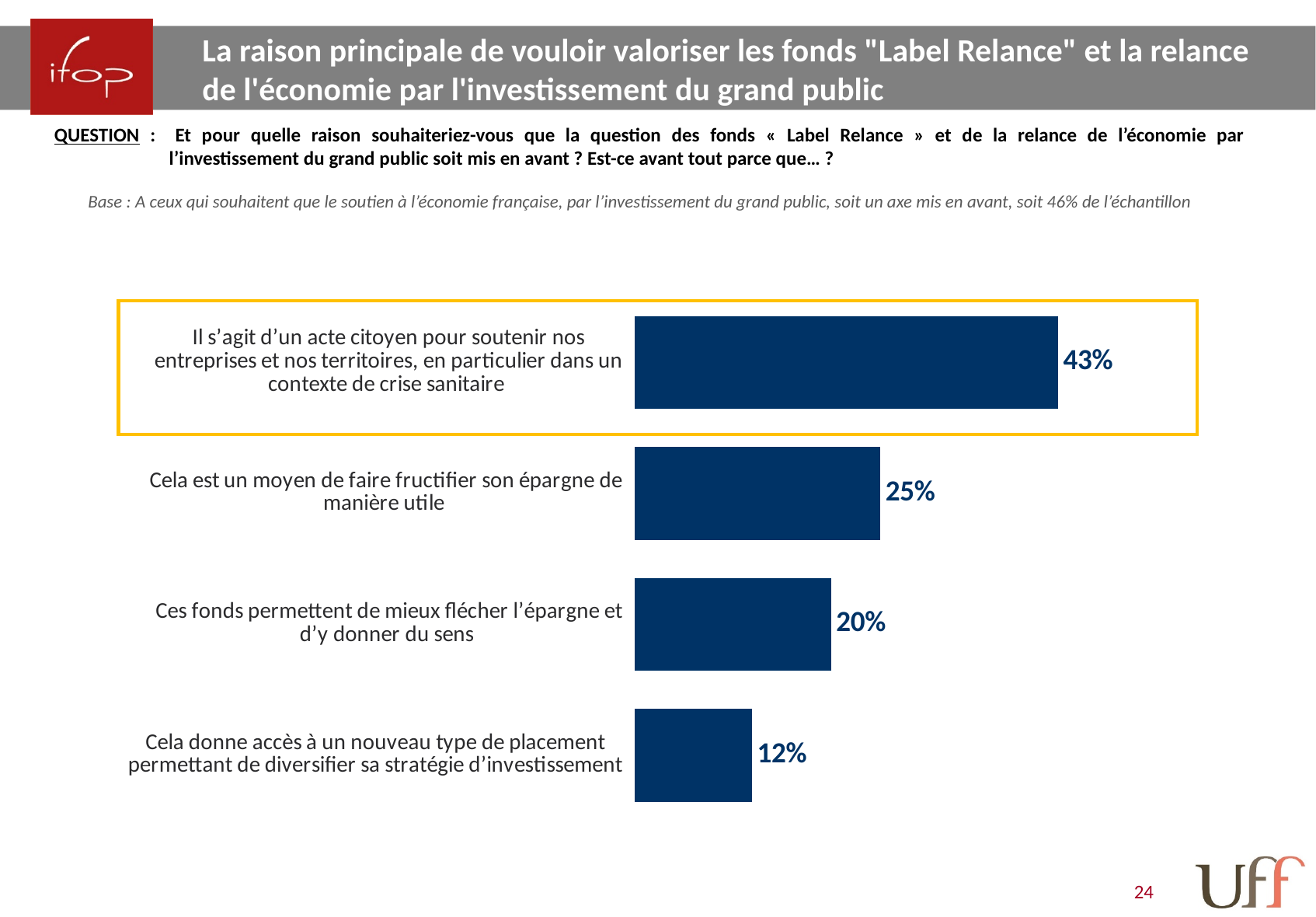
Which reason has the highest percentage? Il s'agit d'un acte citoyen pour soutenir nos entreprises et nos territoires, en particulier dans un contexte de crise sanitaire Which bar is highlighted with a yellow/orange outline box? Il s'agit d'un acte citoyen pour soutenir nos entreprises et nos territoires, en particulier dans un contexte de crise sanitaire What value is shown for "Ces fonds permettent de mieux flécher l'épargne et d'y donner du sens"? 20% What is the difference between "Cela est un moyen de faire fructifier son épargne de manière utile" and "Ces fonds permettent de mieux flécher l'épargne et d'y donner du sens"? 5 points What is the difference in percentage points between the highest reason (43%) and the lowest reason (12%)? 31 points What value is shown for "Cela est un moyen de faire fructifier son épargne de manière utile"? 25% How many reasons (categories) are shown in the chart? 4 What percentage is shown for "Il s'agit d'un acte citoyen pour soutenir nos entreprises et nos territoires, en particulier dans un contexte de crise sanitaire"? 43% Which reason has the lowest percentage? Cela donne accès à un nouveau type de placement permettant de diversifier sa stratégie d'investissement Which is larger: the value for "Cela est un moyen de faire fructifier son épargne de manière utile" or for "Ces fonds permettent de mieux flécher l'épargne et d'y donner du sens"? Cela est un moyen de faire fructifier son épargne de manière utile What type of chart is shown on the slide? Bar chart What value is shown for "Cela donne accès à un nouveau type de placement permettant de diversifier sa stratégie d'investissement"? 12%